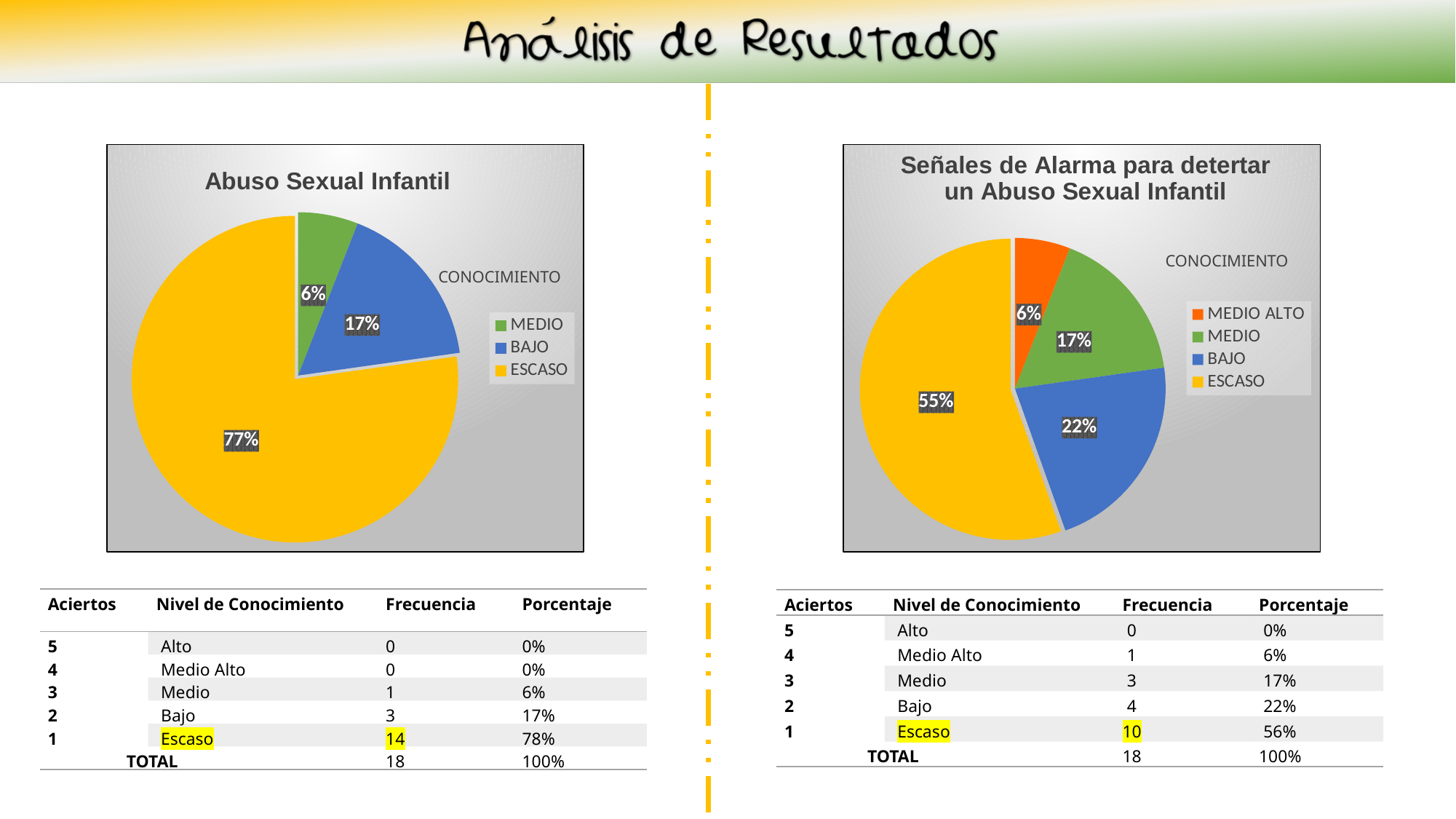
In the "Señales de Alarma para detertar un Abuso Sexual Infantil" chart, what percentage is shown for BAJO? 22% In the "Señales de Alarma para detertar un Abuso Sexual Infantil" chart, what percentage is shown for MEDIO ALTO? 6% In the "Señales de Alarma para detertar un Abuso Sexual Infantil" chart, which is larger, MEDIO or BAJO? BAJO In the "Abuso Sexual Infantil" chart, how many entries does the legend list? 3 In the "Señales de Alarma para detertar un Abuso Sexual Infantil" chart, what colour is the MEDIO ALTO slice? Orange In the "Abuso Sexual Infantil" chart, what percentage is shown for BAJO? 17% In the "Señales de Alarma para detertar un Abuso Sexual Infantil" chart, which category has the largest slice? ESCASO In the "Señales de Alarma para detertar un Abuso Sexual Infantil" chart, what is the difference between the ESCASO and BAJO percentages? 33% In the "Abuso Sexual Infantil" chart, what percentage is shown for ESCASO? 77% What kind of chart is the "Abuso Sexual Infantil" chart? Pie chart In the "Abuso Sexual Infantil" chart, which category has the smallest slice? MEDIO In the "Señales de Alarma para detertar un Abuso Sexual Infantil" chart, how many slices does the pie have? 4